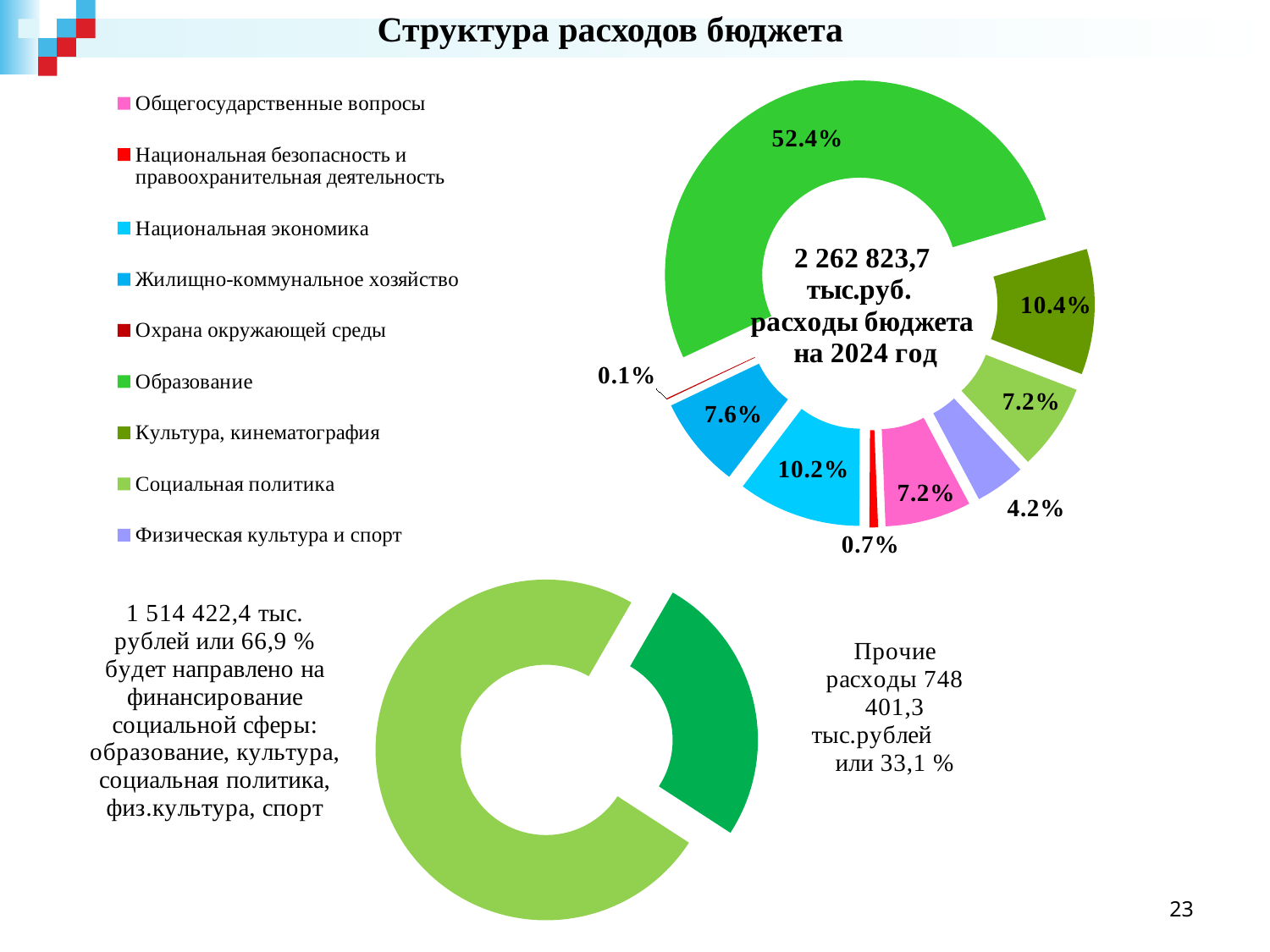
What total budget expenditure for 2024 is shown in the centre of the top chart? 2 262 823,7 тыс.руб. In the top chart, which category has the smallest share? Охрана окружающей среды In the top chart, what share is shown for Культура, кинематография? 10.4% In the top chart, what share is shown for Национальная экономика? 10.2% In the top chart, what share of budget expenditure goes to Образование? 52.4% How many categories does the legend of the top chart list? 9 In the top chart, which is larger: the share for Национальная экономика or the share for Жилищно-коммунальное хозяйство? Национальная экономика In the top chart, which category has the largest share? Образование In the top chart, what share is shown for Физическая культура и спорт? 4.2% In the top chart, what is the difference between the shares of Образование and Культура, кинематография? 42.0% What kind of chart is the top chart on the slide? pie chart (donut) In the top chart, what share is shown for Жилищно-коммунальное хозяйство? 7.6%